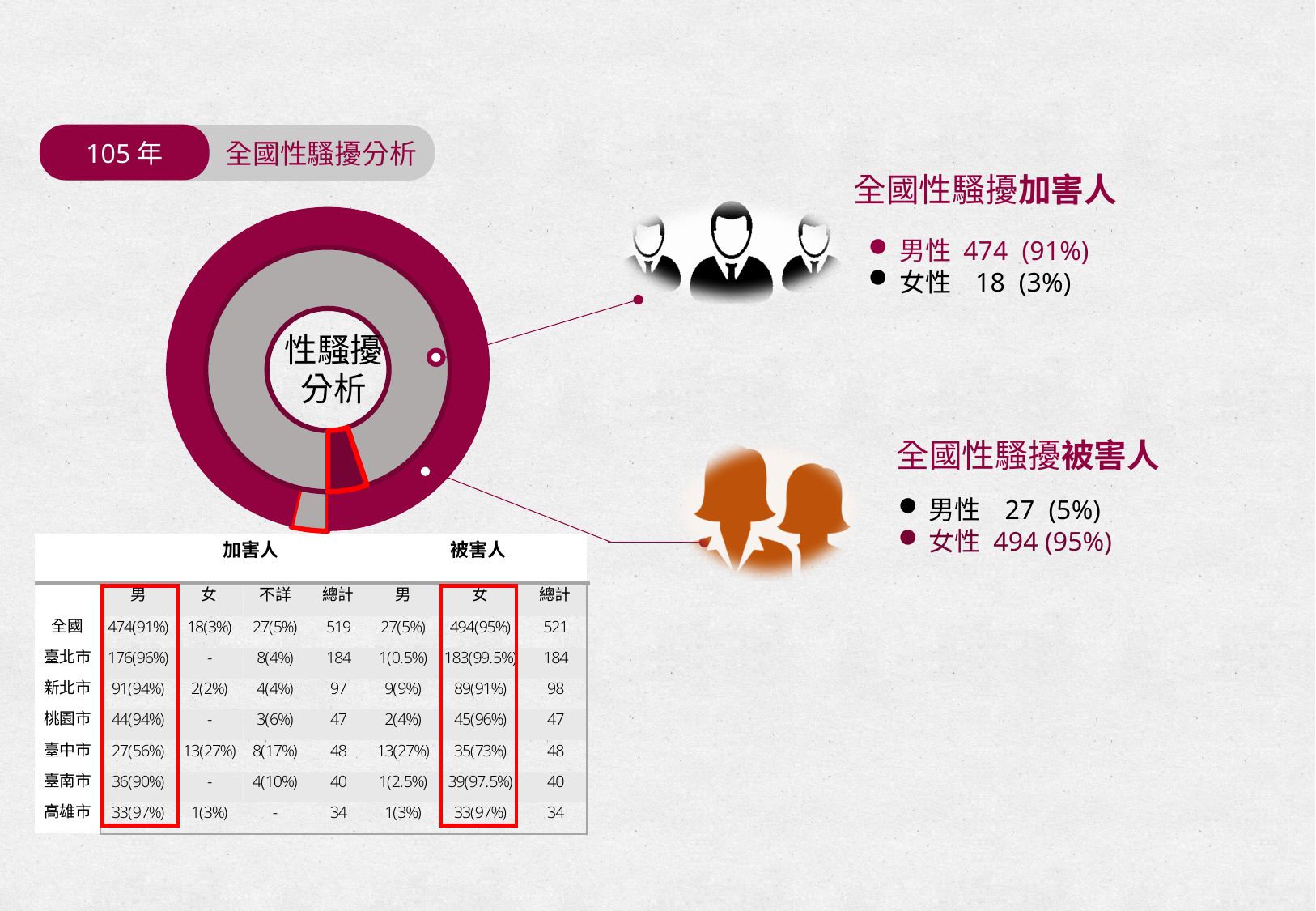
Among 全國性騷擾被害人, which is larger: 男性 or 女性? 女性 What share of 全國性騷擾加害人 is male (男性)? 91% What share of 全國性騷擾被害人 is female (女性)? 95% What text is written in the centre of the donut chart? 性騷擾分析 Among 全國性騷擾加害人, which is larger: 男性 or 女性? 男性 According to the callout for 全國性騷擾被害人, how many female (女性) victims are there? 494 According to the callout for 全國性騷擾被害人, how many male (男性) victims are there? 27 What share of 全國性騷擾加害人 is female (女性)? 3% According to the callout for 全國性騷擾加害人, how many male (男性) perpetrators are there? 474 According to the callout for 全國性騷擾加害人, how many female (女性) perpetrators are there? 18 What kind of chart is shown on the left of the slide? pie chart (donut) What is the difference between the number of male (474) and female (18) perpetrators in 全國性騷擾加害人? 456